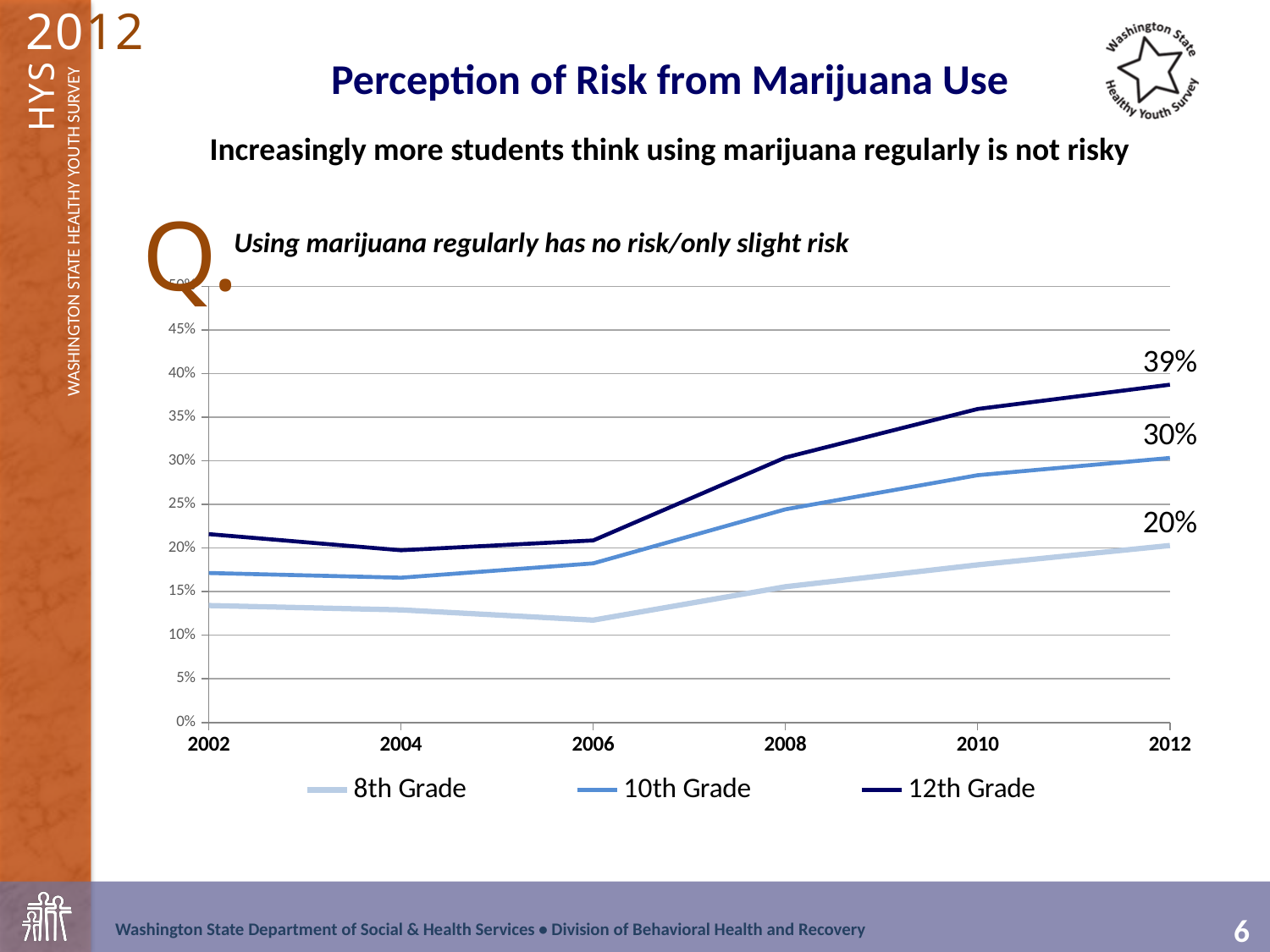
What is the value for 12th Grade in 2012? 39% Is the value for 8th Grade in 2006 greater or less than 15%? less Which grade has the highest value in 2012? 12th Grade How many years are shown on the x axis? 6 What is the value for 8th Grade in 2012? 20% How many series does the legend list? 3 What is the value for 10th Grade in 2012? 30% Which is larger in 2012, the 10th Grade value or the 8th Grade value? 10th Grade What is the difference between the 12th Grade and 8th Grade values in 2012? 19 percentage points What kind of chart is shown on the slide? Line chart Which grade has the lowest value in 2012? 8th Grade Is the value for 12th Grade in 2004 greater or less than 25%? less